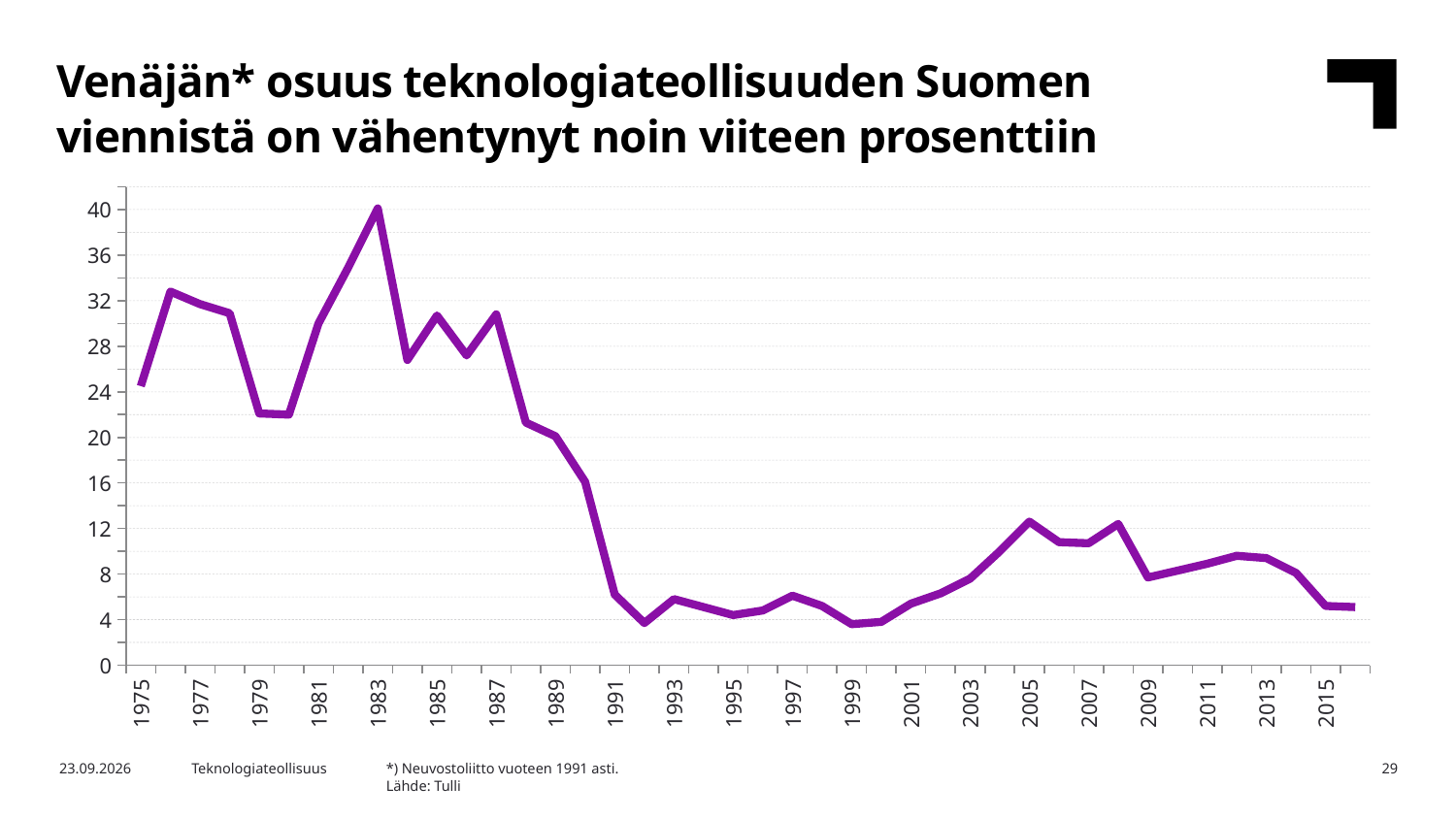
Is the value for 2015 greater or less than 8? less Overall, do the values rise or fall from 1975 to the end of the series? fall What is the first year shown on the x axis? 1975 Which year has the larger value, 1983 or 1991? 1983 Is the value for 1991 greater or less than 8? less What kind of chart is shown on the slide? line chart How many lines are plotted on the chart? 1 Which year has the larger value, 1979 or 1987? 1987 In which year does the line reach its highest value? 1983 Is the value for 1975 greater or less than 20? greater